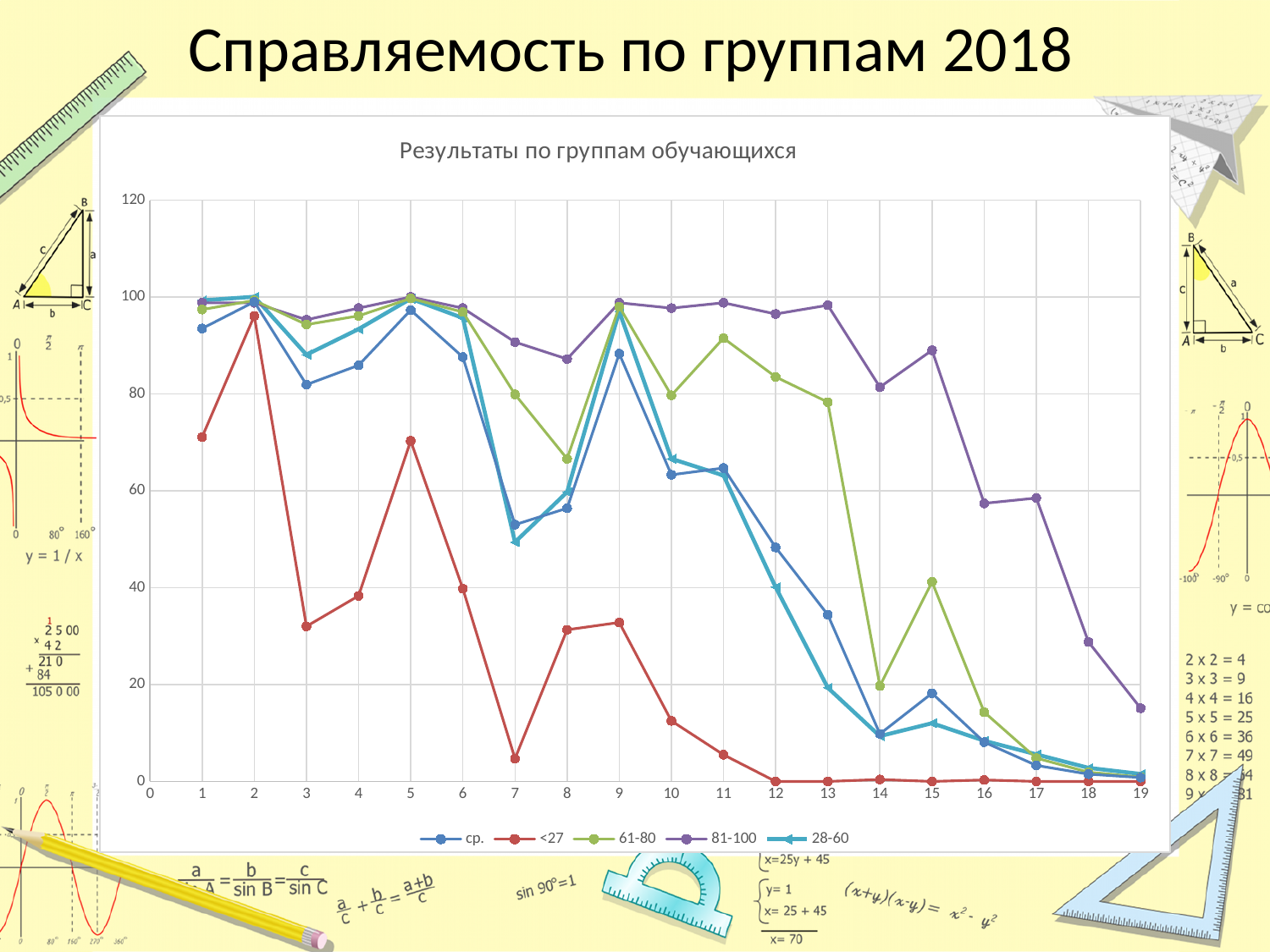
How many series does the legend list? 5 At point 15, which series has the larger value: 61-80 or ср.? 61-80 Which series has the highest value at point 14? 81-100 What kind of chart is shown on the slide? line chart Is the value of the 61-80 series at point 15 greater or less than 20? greater Which series are listed in the legend? ср., <27, 61-80, 81-100, 28-60 Is the value of the 81-100 series at point 19 greater or less than 20? less Is the value of the <27 series at point 7 greater or less than 20? less At point 13, which series has the larger value: 81-100 or <27? 81-100 What is the title printed inside the chart area? Результаты по группам обучающихся Which series has the lowest value at point 1? <27